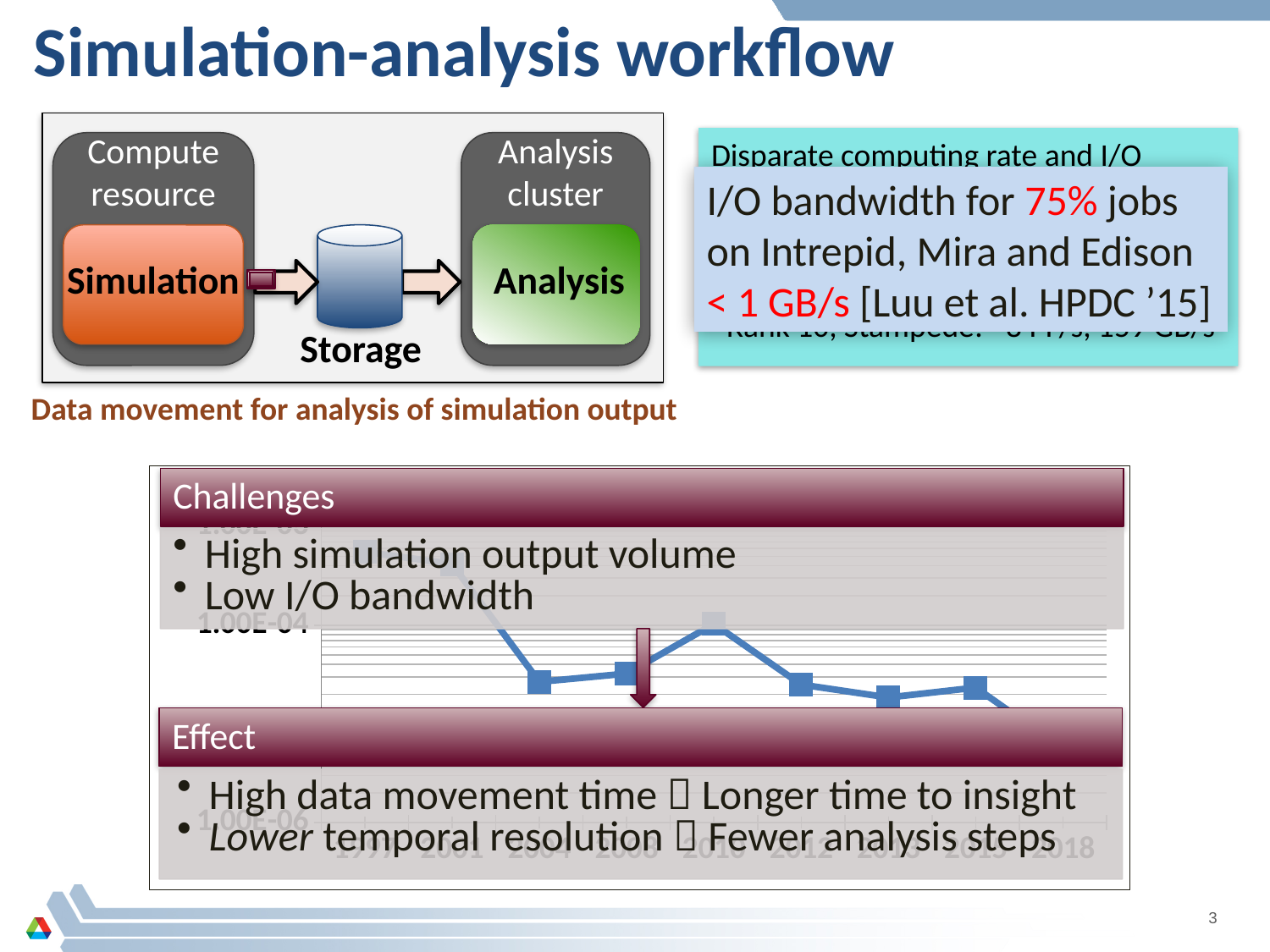
What colour is the line plotted on the chart? blue Which is larger on the line chart, the value at 2004 or the value at 2010? 2010 What kind of chart is shown behind the Challenges and Effect boxes? line chart Which is larger on the line chart, the value at 2008 or the value at 2010? 2010 Which is larger on the line chart, the value at 2010 or the value at 2012? 2010 What shape are the data markers on the line chart? squares Is the value for 2012 on the line chart greater or less than 1.00E-04? less Overall, do the values on the line chart rise or fall from left to right along the x axis? fall Is the value for 2004 on the line chart greater or less than 1.00E-04? less Is the value for 2015 on the line chart greater or less than 1.00E-04? less